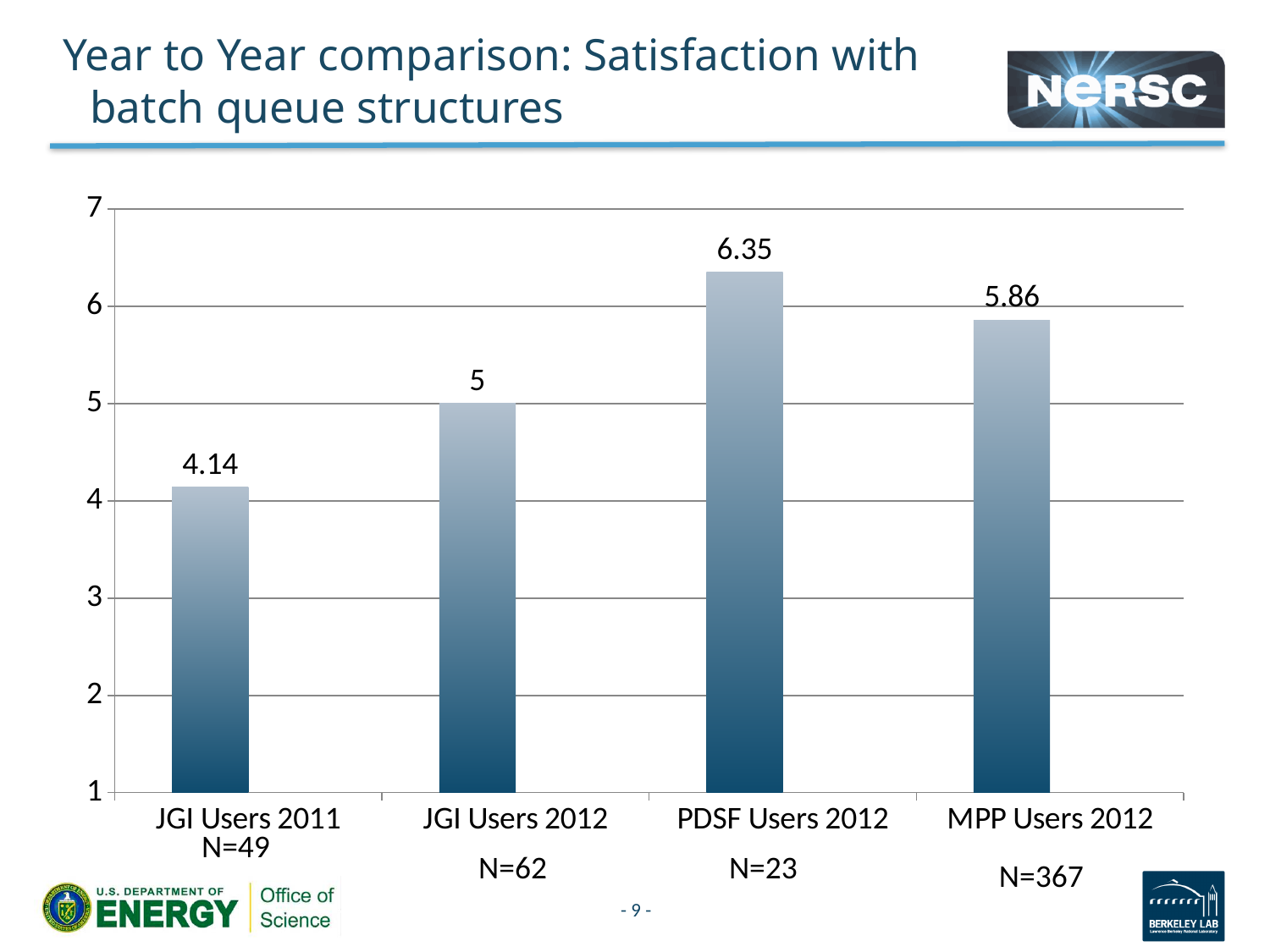
Which is larger, the value for MPP Users 2012 or the value for JGI Users 2012? MPP Users 2012 What is the value for JGI Users 2011? 4.14 What is the value for MPP Users 2012? 5.86 Which category has the lowest value? JGI Users 2011 What is the value for JGI Users 2012? 5 How many categories are shown in the chart? 4 What is the value for PDSF Users 2012? 6.35 What kind of chart is shown on the slide? Bar chart What is the difference between the values for PDSF Users 2012 and MPP Users 2012? 0.49 What is the N value shown for MPP Users 2012? N=367 Which category has the highest value? PDSF Users 2012 What is the difference between the values for JGI Users 2012 and JGI Users 2011? 0.86